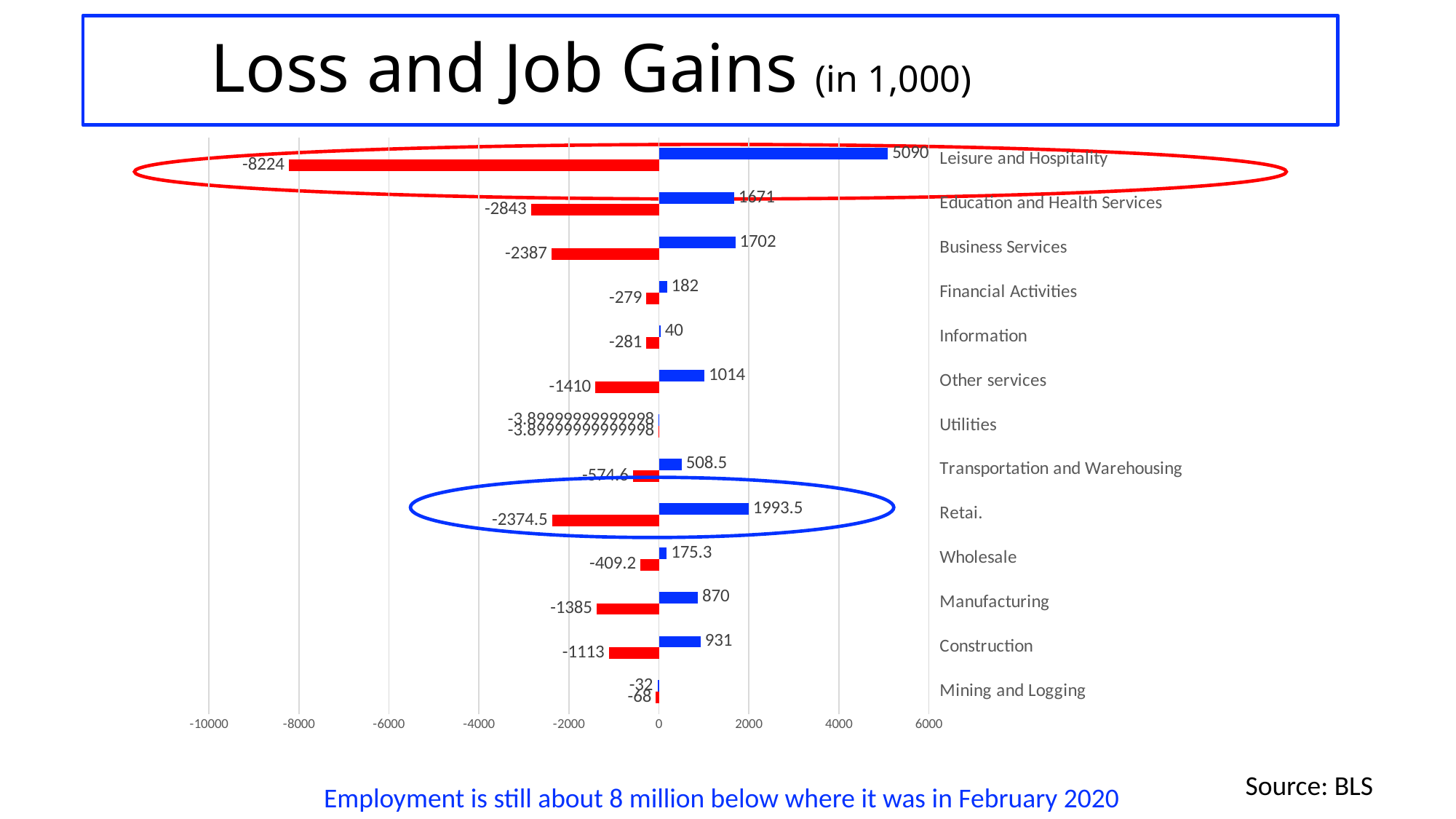
Which category has the largest job loss (longest red bar)? Leisure and Hospitality What is the job gain value shown for Retail? 1993.5 What is the job gain value shown for Wholesale? 175.3 Is the job gain value for Transportation and Warehousing greater or less than 1000? less What is the job loss value shown for Leisure and Hospitality? -8224 Which has the larger job gain, Manufacturing or Construction? Construction Which category has the largest job gain (longest blue bar)? Leisure and Hospitality What colour are the bars representing job losses? red How much larger is the job gain for Leisure and Hospitality than the job gain for Education and Health Services? 3419 What kind of chart is shown on the slide? bar chart What is the job loss value shown for Manufacturing? -1385 How many industry categories are shown on the chart? 13